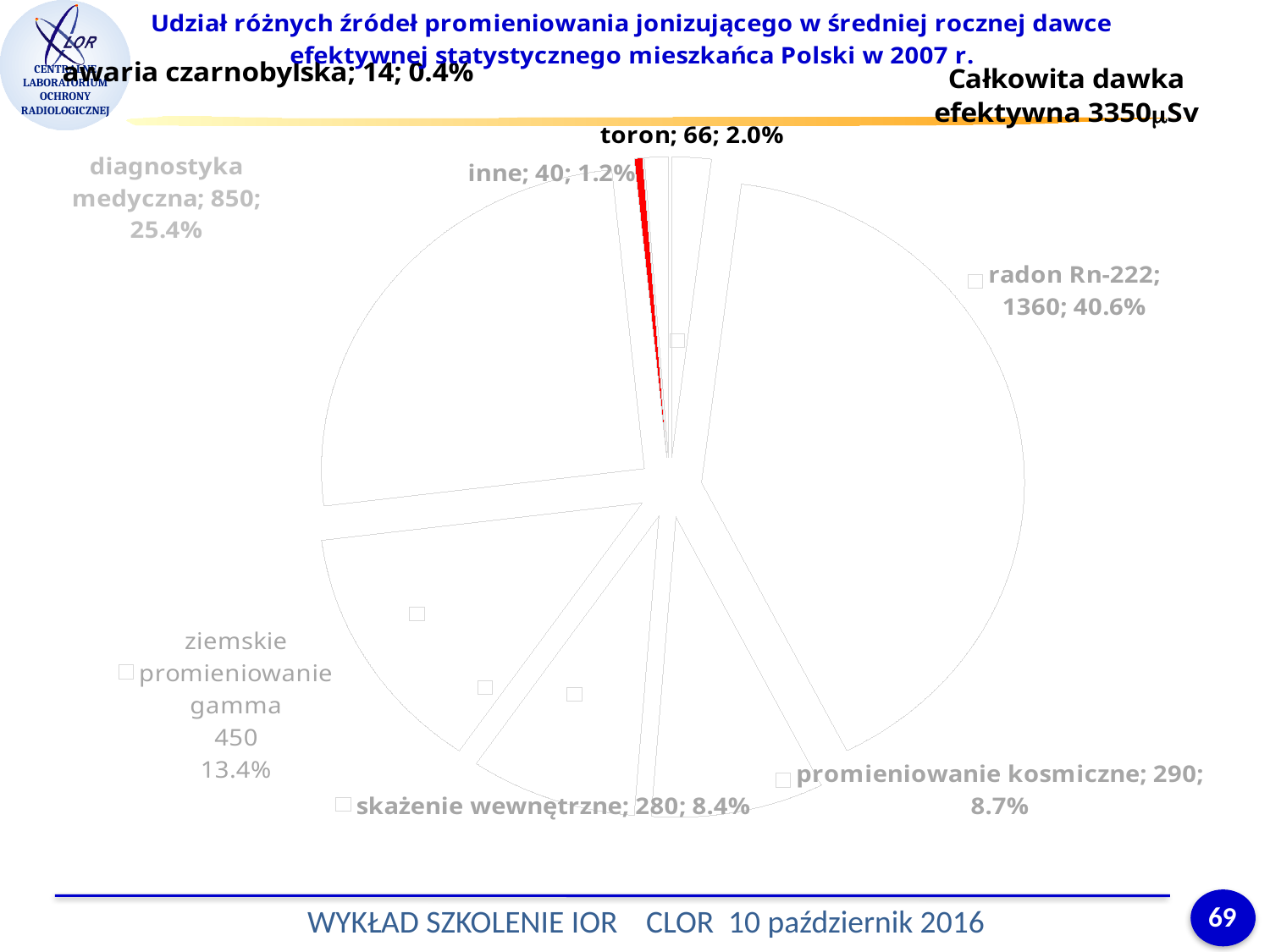
What is the value for ziemskie promieniowanie gamma? 450 How many categories are shown in the pie chart? 8 Which is larger, the value for promieniowanie kosmiczne or the value for skażenie wewnętrzne? promieniowanie kosmiczne What is the difference between the values for radon Rn-222 and diagnostyka medyczna? 510 What is the value for skażenie wewnętrzne? 280 What percentage is shown for toron? 2.0% What share of the pie does diagnostyka medyczna represent? 25.4% Which category has the largest share of the pie? radon Rn-222 Which category has the smallest share of the pie? awaria czarnobylska What total effective dose (Całkowita dawka efektywna) is stated on the slide? 3350 μSv What is the value for radon Rn-222? 1360 What kind of chart is shown on the slide? pie chart